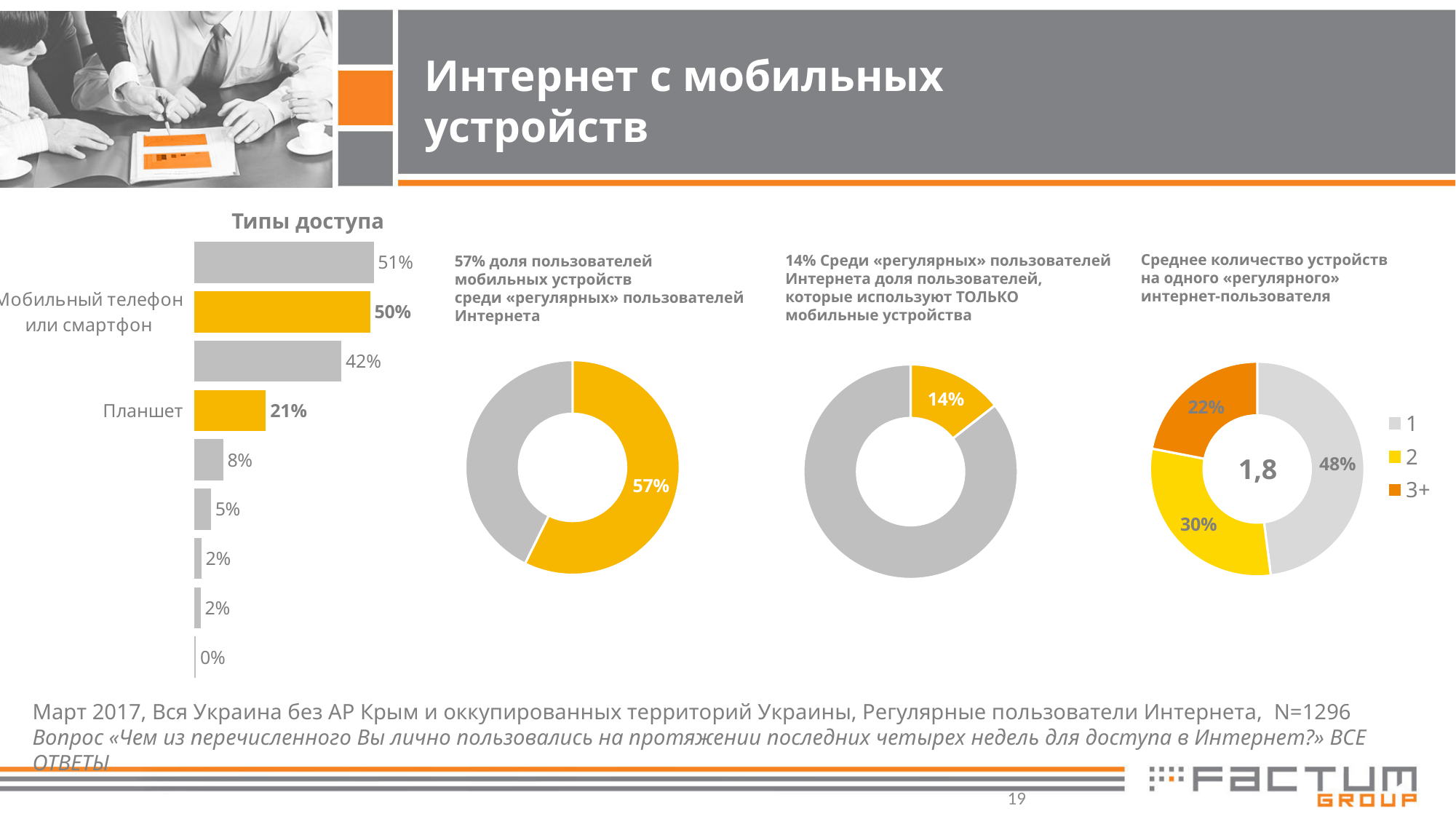
In the bar chart 'Типы доступа', what is the difference between the values for 'Мобильный телефон или смартфон' and 'Планшет'? 29% In the bar chart 'Типы доступа', what is the value of the bottom bar? 0% In the bar chart 'Типы доступа', which has the larger value: 'Мобильный телефон или смартфон' or 'Планшет'? Мобильный телефон или смартфон What kind of chart is 'Типы доступа'? bar chart In the rightmost donut chart (average number of devices per regular internet user), what is the share for '3+'? 22% In the bar chart 'Типы доступа', what is the value for 'Планшет'? 21% How many entries does the legend of the rightmost donut chart list? 3 In the rightmost donut chart (average number of devices per regular internet user), which category has the largest share? 1 How many bars are shown in the bar chart 'Типы доступа'? 9 In the bar chart 'Типы доступа', what is the value of the topmost bar? 51% In the bar chart 'Типы доступа', what is the value for 'Мобильный телефон или смартфон'? 50% In the rightmost donut chart (average number of devices per regular internet user), what is the share for '1'? 48%